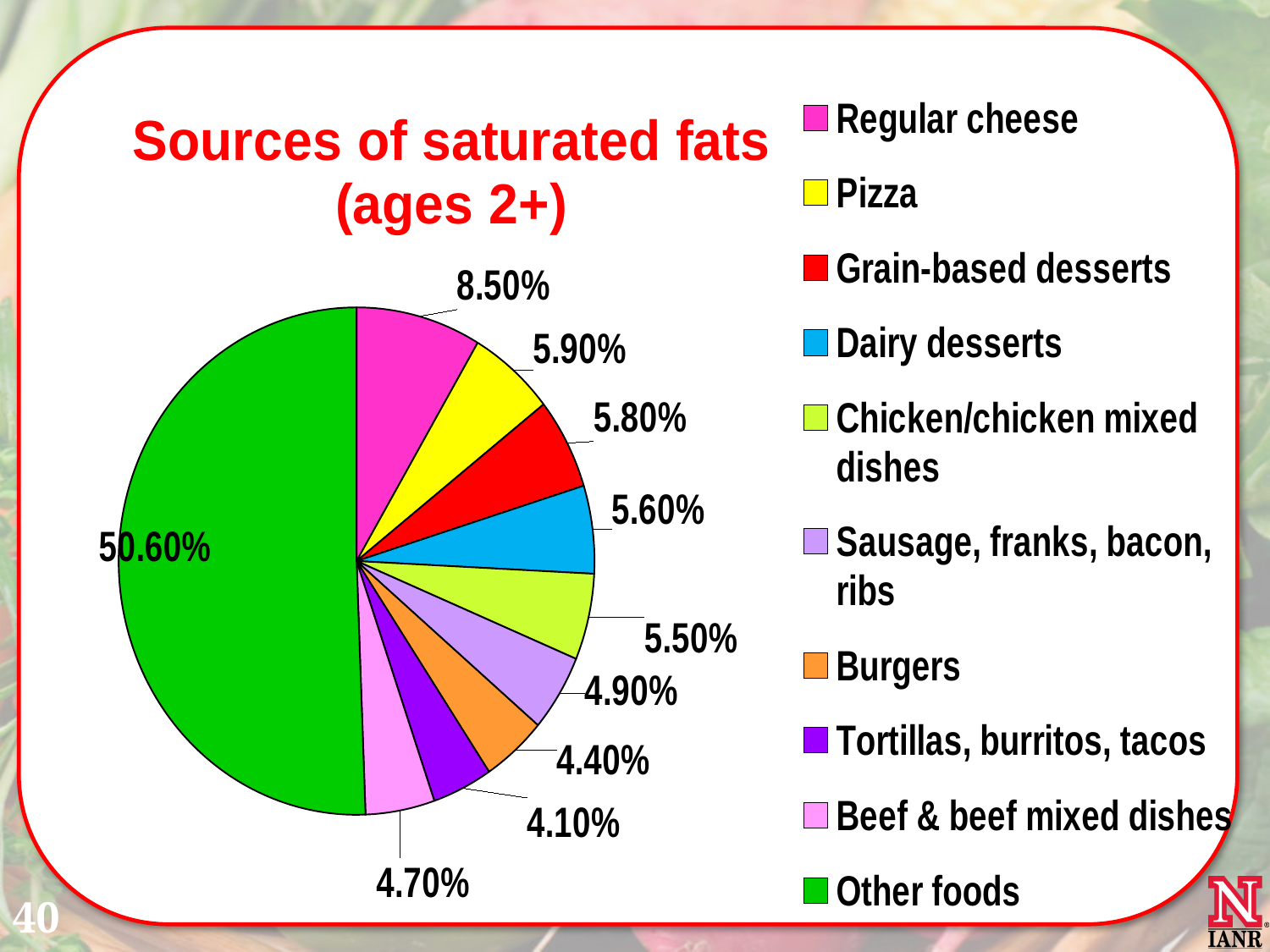
What share of saturated fats comes from Pizza? 5.90% What share of saturated fats comes from Beef & beef mixed dishes? 4.70% Which is larger, the share for Sausage, franks, bacon, ribs or the share for Burgers? Sausage, franks, bacon, ribs What share of saturated fats comes from Regular cheese? 8.50% How many categories does the legend list? 10 What is the title of the chart? Sources of saturated fats (ages 2+) What colour is the slice for Other foods? green What share of saturated fats comes from Burgers? 4.40% Which category has the largest slice of the pie? Other foods What kind of chart is shown on the slide? pie chart What is the difference in percentage points between Regular cheese and Dairy desserts? 2.90 Which category has the smallest slice of the pie? Tortillas, burritos, tacos